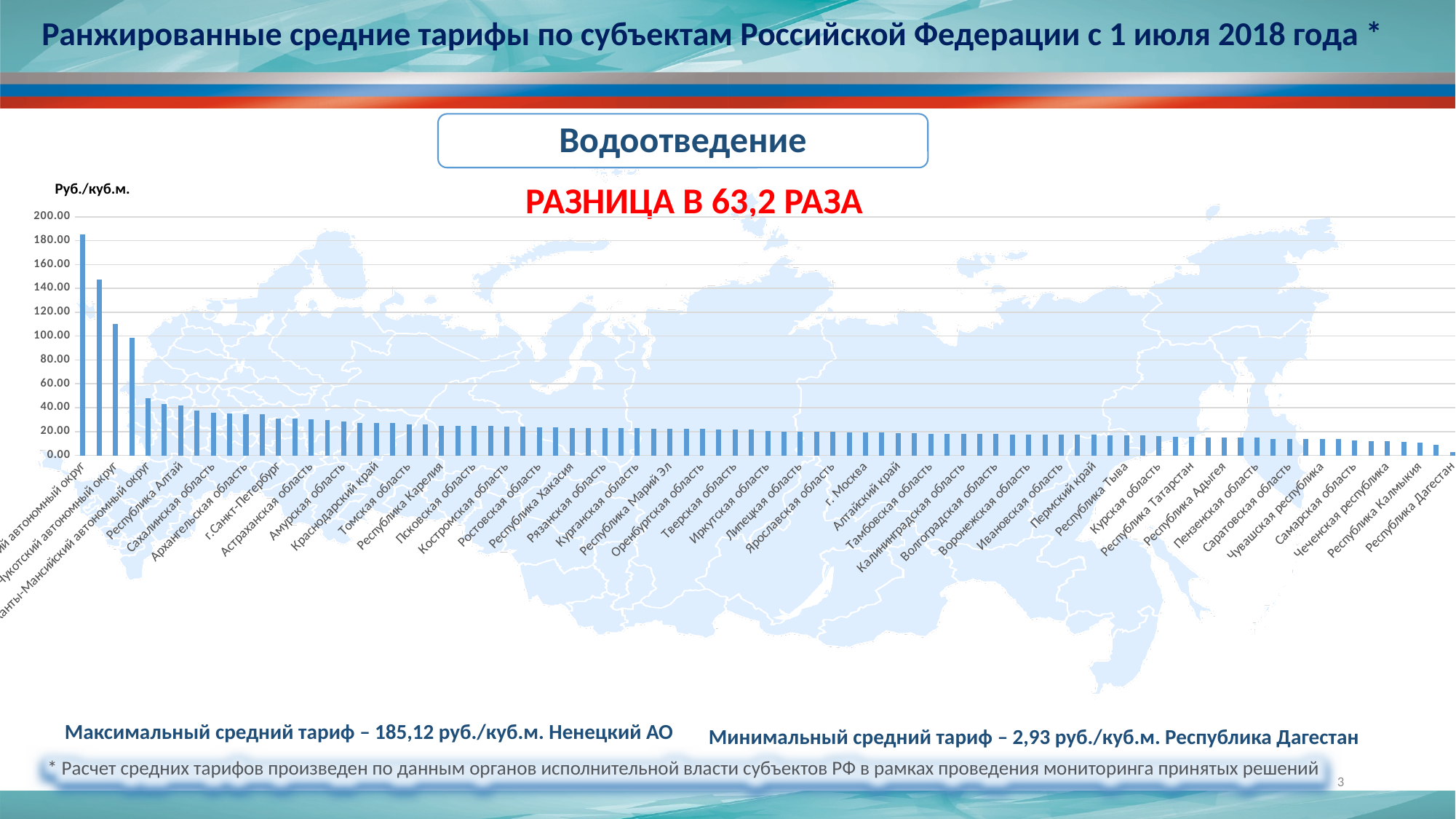
Is the value for Республика Алтай greater or less than 120? less Is the value for Чукотский автономный округ greater or less than 120? less What unit is shown on the y axis of the chart? Руб./куб.м. What is the maximum average tariff shown on the slide? 185,12 руб./куб.м. Do the values rise or fall from left to right along the x axis? fall Which region has the lowest average water disposal tariff on the chart? Республика Дагестан What kind of chart is shown on the slide? bar chart Is the value for г. Москва greater or less than 40? less Which has a larger value, Чукотский автономный округ or Ханты-Мансийский автономный округ? Чукотский автономный округ By how many times do the tariffs differ according to the red text above the chart? 63,2 раза What is the minimum average tariff shown on the slide? 2,93 руб./куб.м. Which region has the highest average water disposal tariff on the chart? Ненецкий АО